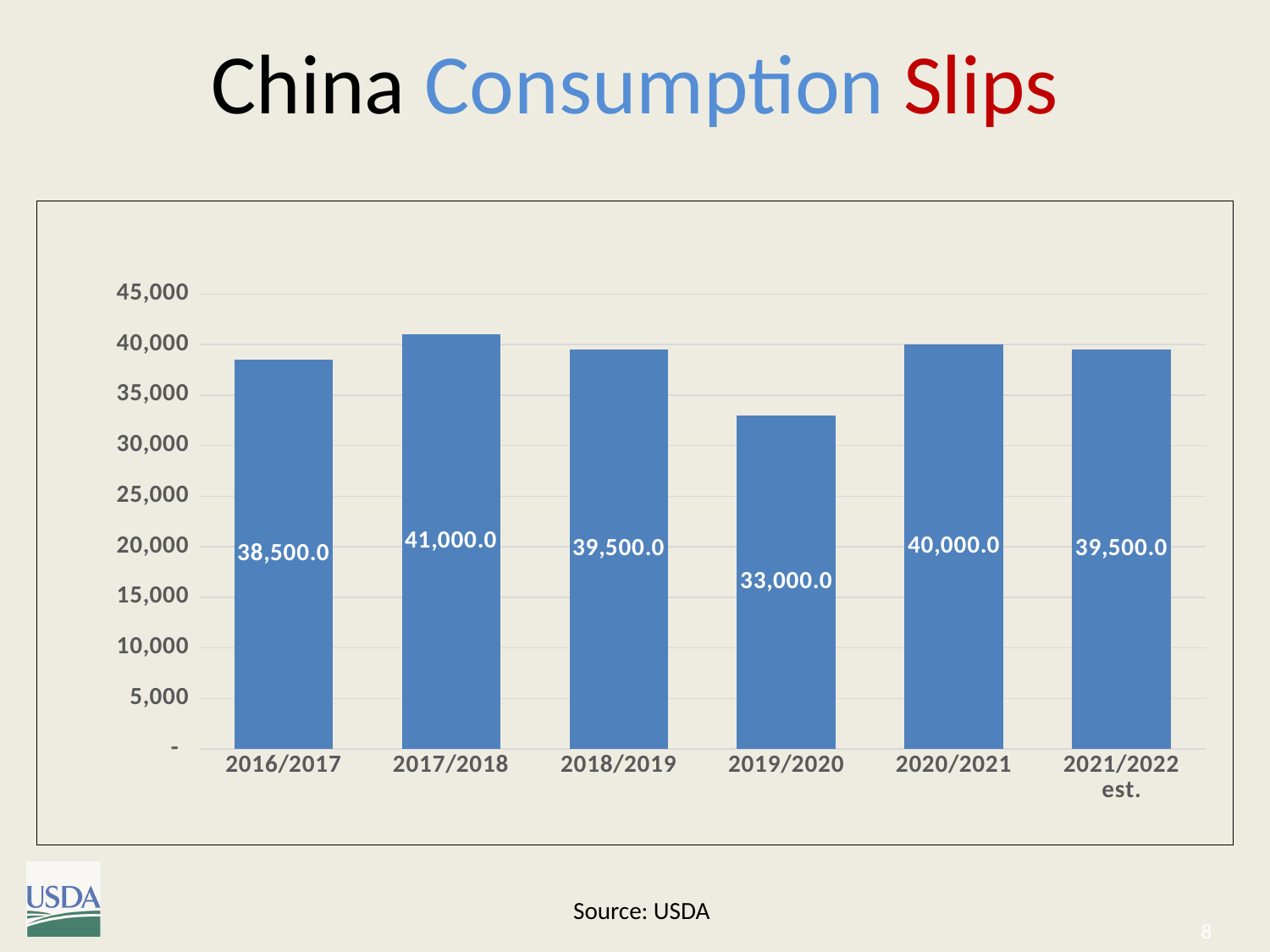
What is the value for 2019/2020? 33,000.0 What kind of chart is shown on the slide? bar chart How many years are shown on the chart? 6 Which year has the highest value? 2017/2018 Is the value for 2019/2020 greater or less than 35,000? less What is the value for 2021/2022 est.? 39,500.0 What is the difference between the values for 2020/2021 and 2021/2022 est.? 500.0 What is the title of the slide? China Consumption Slips Which is larger, the value for 2016/2017 or the value for 2018/2019? 2018/2019 What is the value for 2016/2017? 38,500.0 Which year has the lowest value? 2019/2020 What is the difference between the values for 2017/2018 and 2019/2020? 8,000.0